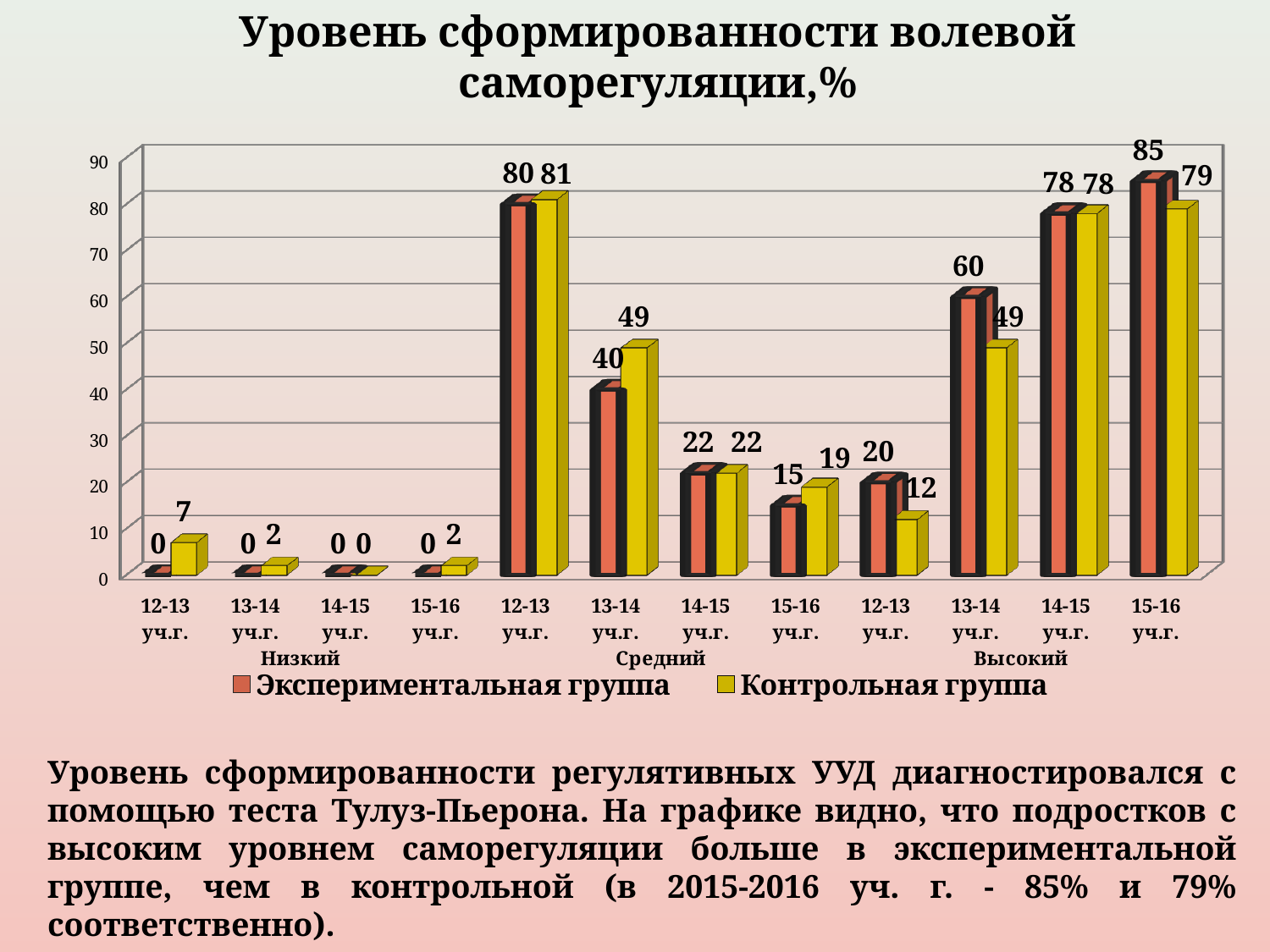
What is the value for Контрольная группа in the Средний group for 13-14 уч.г.? 49 In the Средний group for 15-16 уч.г., which series has the larger value, Экспериментальная группа or Контрольная группа? Контрольная группа What kind of chart is shown on the slide? Bar chart Across the Высокий group, do the values for Экспериментальная группа rise or fall from 12-13 уч.г. to 15-16 уч.г.? Rise In the Высокий group for 12-13 уч.г., which series has the larger value, Экспериментальная группа or Контрольная группа? Экспериментальная группа What is the difference between Экспериментальная группа and Контрольная группа in the Высокий group for 15-16 уч.г.? 6 Which category has the highest value for Экспериментальная группа? 15-16 уч.г. (Высокий) What is the difference between Экспериментальная группа and Контрольная группа in the Высокий group for 13-14 уч.г.? 11 What is the value for Экспериментальная группа in the Высокий group for 15-16 уч.г.? 85 What is the value for Контрольная группа in the Низкий group for 12-13 уч.г.? 7 How many series does the legend list? 2 How many categories are shown on the x axis? 12